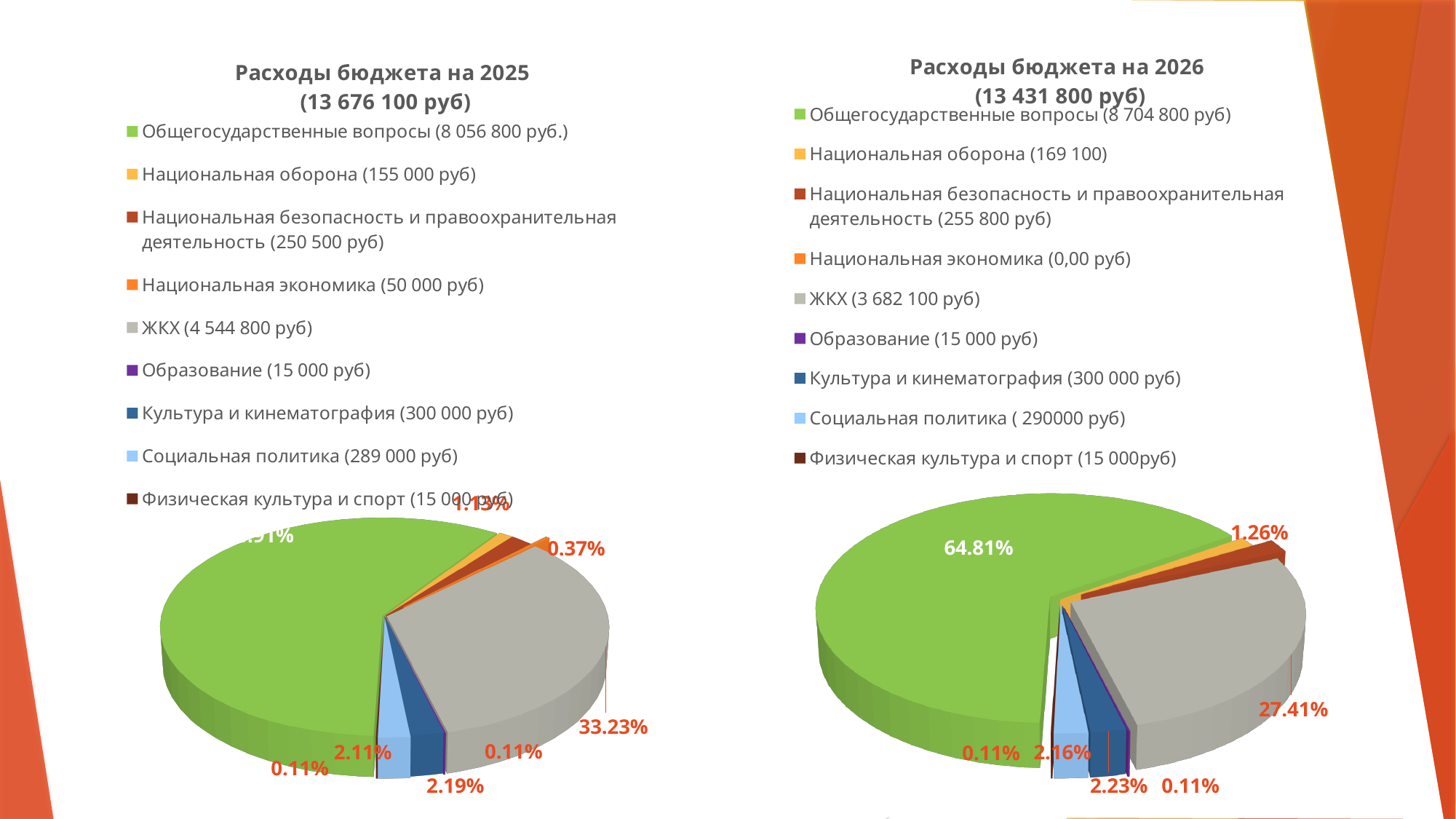
In the 'Расходы бюджета на 2025' chart, what share is shown for 'Культура и кинематография'? 2.19% In the 'Расходы бюджета на 2026' chart, which is larger: the slice for 'ЖКХ' or the slice for 'Социальная политика'? ЖКХ In the 'Расходы бюджета на 2026' chart, what share is shown for 'ЖКХ'? 27.41% How many categories does the legend of the 'Расходы бюджета на 2026' chart list? 9 In the 'Расходы бюджета на 2026' chart, what share is shown for 'Национальная оборона'? 1.26% According to the legend of the 'Расходы бюджета на 2025' chart, what amount is given for 'ЖКХ'? 4 544 800 руб What kind of chart is used on the left side of the slide for 'Расходы бюджета на 2025'? pie chart What total amount is shown in the title of the 'Расходы бюджета на 2026' chart? 13 431 800 руб In the 'Расходы бюджета на 2025' chart, which category has the largest slice? Общегосударственные вопросы